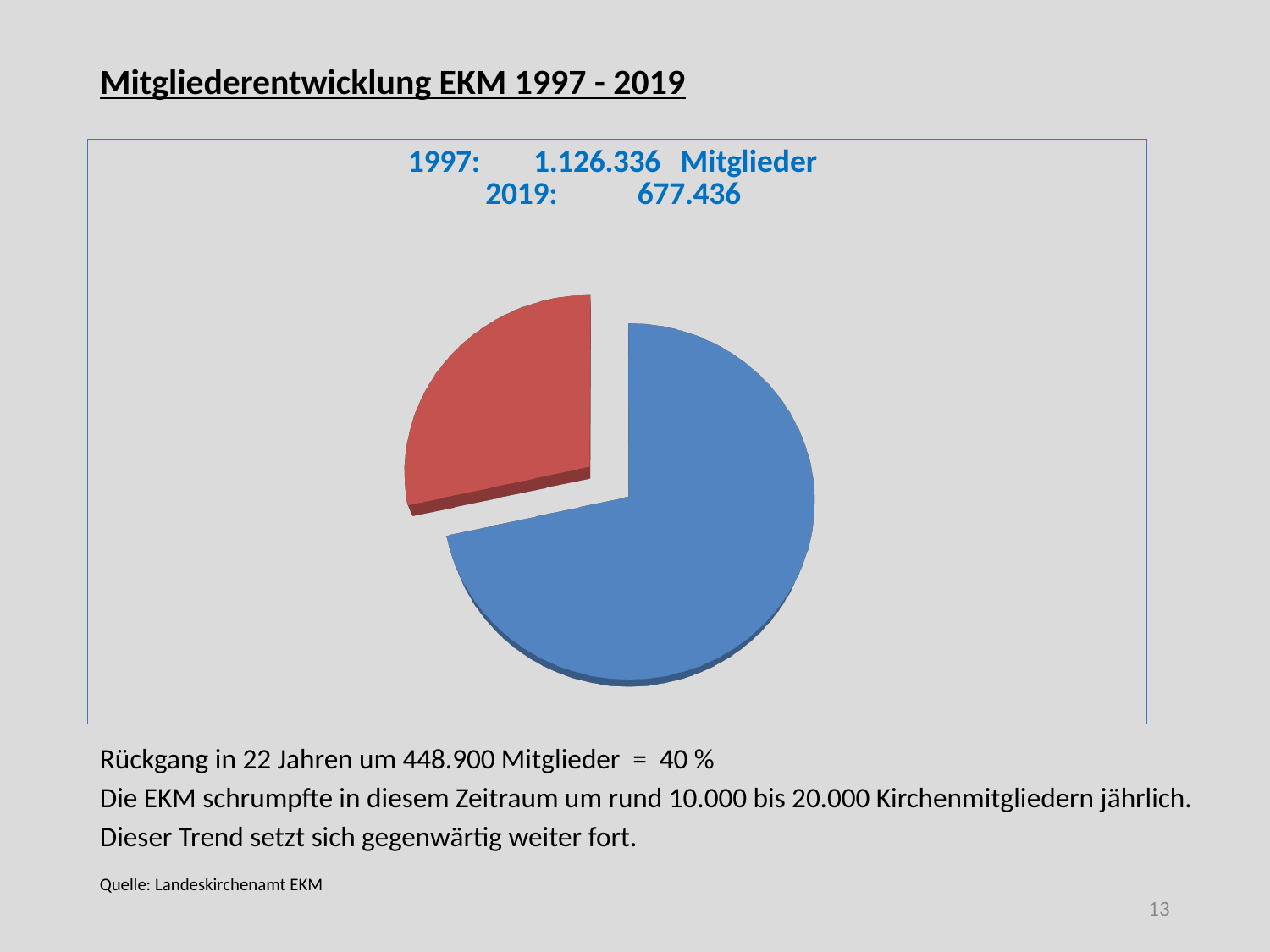
How many slices does the pie chart have? 2 What kind of chart is shown on the slide? pie chart Which year shown in the chart title has the higher membership figure, 1997 or 2019? 1997 Which colour is the smaller, exploded slice of the pie chart? red Did EKM membership rise or fall between 1997 and 2019? fall By how many members did the EKM membership decline between 1997 and 2019? 448.900 What is the title of the slide above the chart? Mitgliederentwicklung EKM 1997 - 2019 What percentage decline in membership does the slide state for the 22-year period? 40 % Which slice of the pie chart is larger, the blue one or the red one? the blue one According to the chart title, how many members (Mitglieder) did the EKM have in 1997? 1.126.336 According to the chart title, how many members did the EKM have in 2019? 677.436